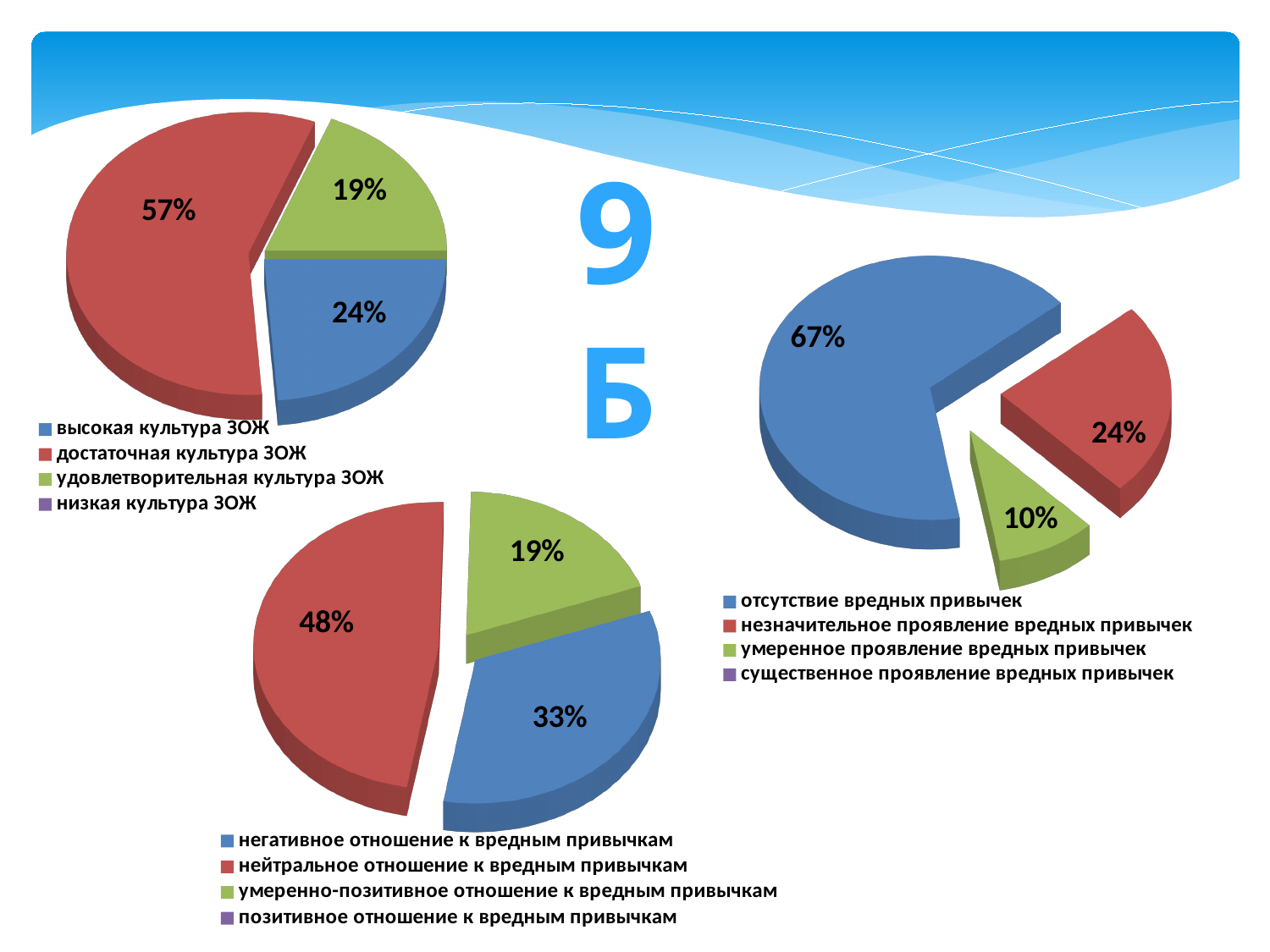
In the right-hand pie chart, what share is labelled for 'умеренное проявление вредных привычек'? 10% In the top-left pie chart, what is the difference between the shares for 'достаточная культура ЗОЖ' and 'удовлетворительная культура ЗОЖ'? 38% In the bottom-center pie chart, what share is labelled for 'негативное отношение к вредным привычкам'? 33% In the right-hand pie chart, which is larger: 'незначительное проявление вредных привычек' or 'умеренное проявление вредных привычек'? незначительное проявление вредных привычек In the top-left pie chart, what share is labelled for 'достаточная культура ЗОЖ'? 57% In the bottom-center pie chart, which category has the smallest labelled slice? умеренно-позитивное отношение к вредным привычкам In the right-hand pie chart, what share is labelled for 'отсутствие вредных привычек'? 67% What type of chart is the top-left chart? Pie chart In the top-left pie chart, what share is labelled for 'высокая культура ЗОЖ'? 24% In the top-left pie chart, which category has the largest slice? достаточная культура ЗОЖ How many entries does the legend of the right-hand pie chart list? 4 In the bottom-center pie chart, what share is labelled for 'нейтральное отношение к вредным привычкам'? 48%